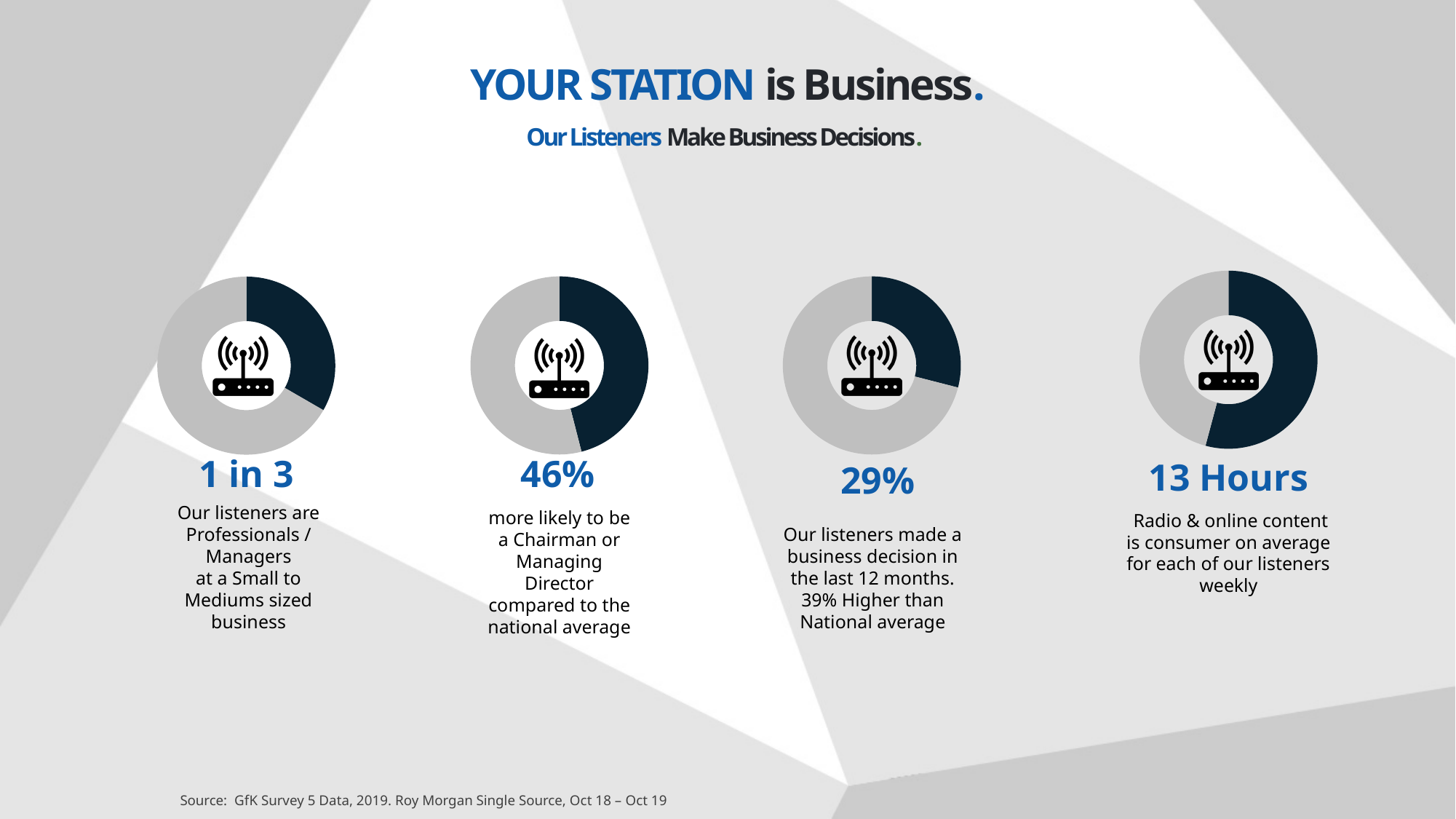
What kind of chart is used for each of the four statistics on the slide? Donut (pie) chart Which is larger: the 'more likely to be a Chairman or Managing Director' figure or the 'made a business decision in the last 12 months' figure? 46% (Chairman or Managing Director) What colour is the highlighted segment in each donut chart? Dark navy blue What is the difference in percentage points between the 46% figure in the second chart and the 29% figure in the third chart? 17 percentage points According to the third chart's caption, how much higher than the national average is the share of listeners who made a business decision? 39% In the third chart from the left, what percentage of listeners made a business decision in the last 12 months? 29% In the second chart from the left, how much more likely are listeners to be a Chairman or Managing Director compared to the national average? 46% In the rightmost chart, how many hours of radio & online content are consumed on average by each listener weekly? 13 Hours In the leftmost chart, what proportion of listeners are Professionals / Managers at a small to medium sized business? 1 in 3 How many donut charts are shown on the slide? 4 What is the subtitle shown beneath the main title of the slide? Our Listeners Make Business Decisions.